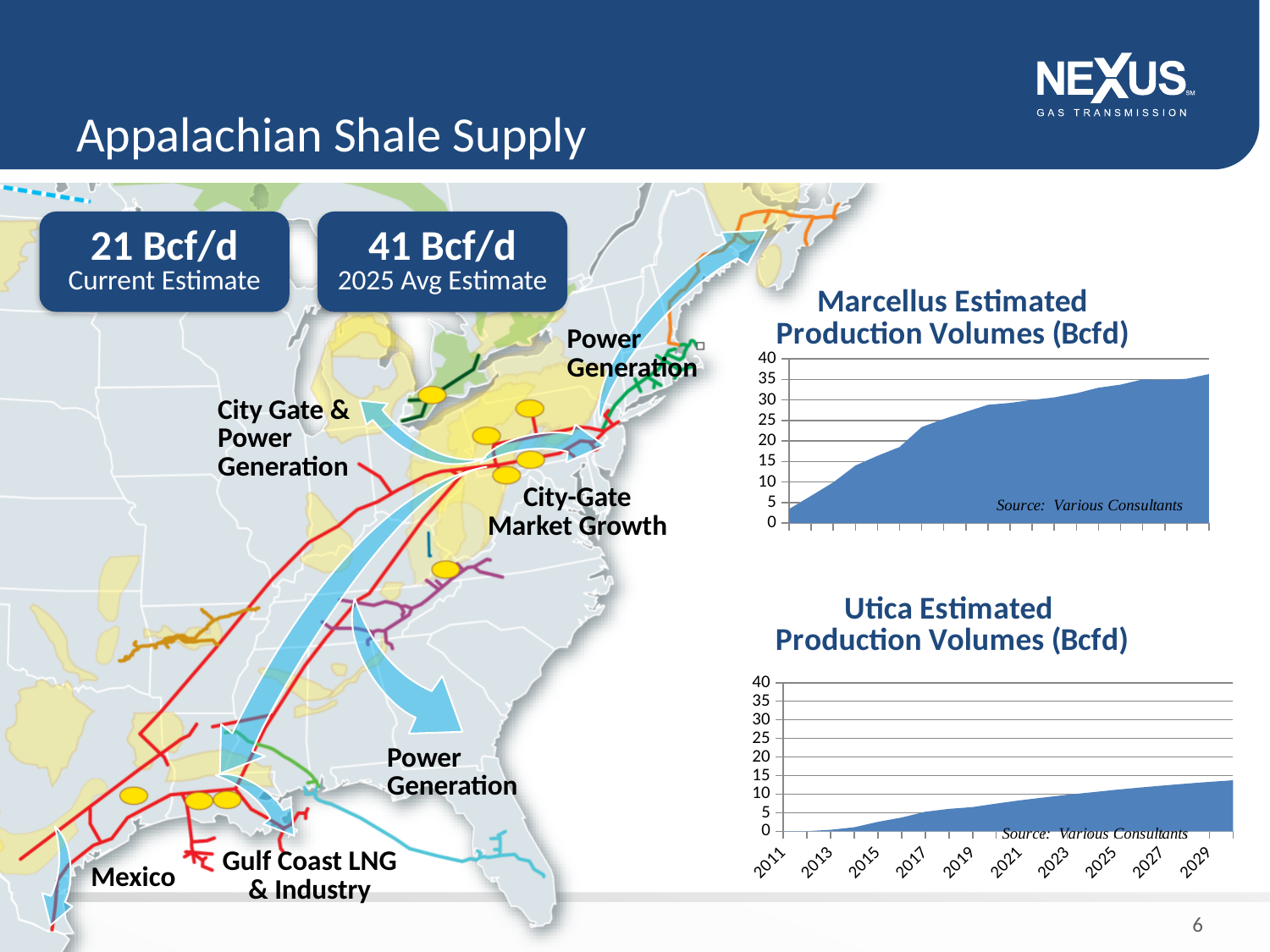
In the Marcellus Estimated Production Volumes chart, do the values rise or fall along the x axis? Rise In the Utica Estimated Production Volumes chart, do the values rise or fall from 2011 to 2029? Rise What kind of chart is the Marcellus Estimated Production Volumes (Bcfd) chart? Area chart How many year labels are shown on the x axis of the Utica Estimated Production Volumes chart? 10 In the Utica Estimated Production Volumes chart, is the value for 2011 greater or less than 5? less In the Marcellus Estimated Production Volumes chart, is the value at the left end of the series greater or less than 10? less In the Marcellus Estimated Production Volumes chart, is the value at the right end of the series greater or less than 30? greater What kind of chart is the Utica Estimated Production Volumes (Bcfd) chart? Area chart Which chart shows the higher value at the end of its series, Marcellus Estimated Production Volumes or Utica Estimated Production Volumes? Marcellus Estimated Production Volumes What source is cited on the Marcellus Estimated Production Volumes chart? Various Consultants